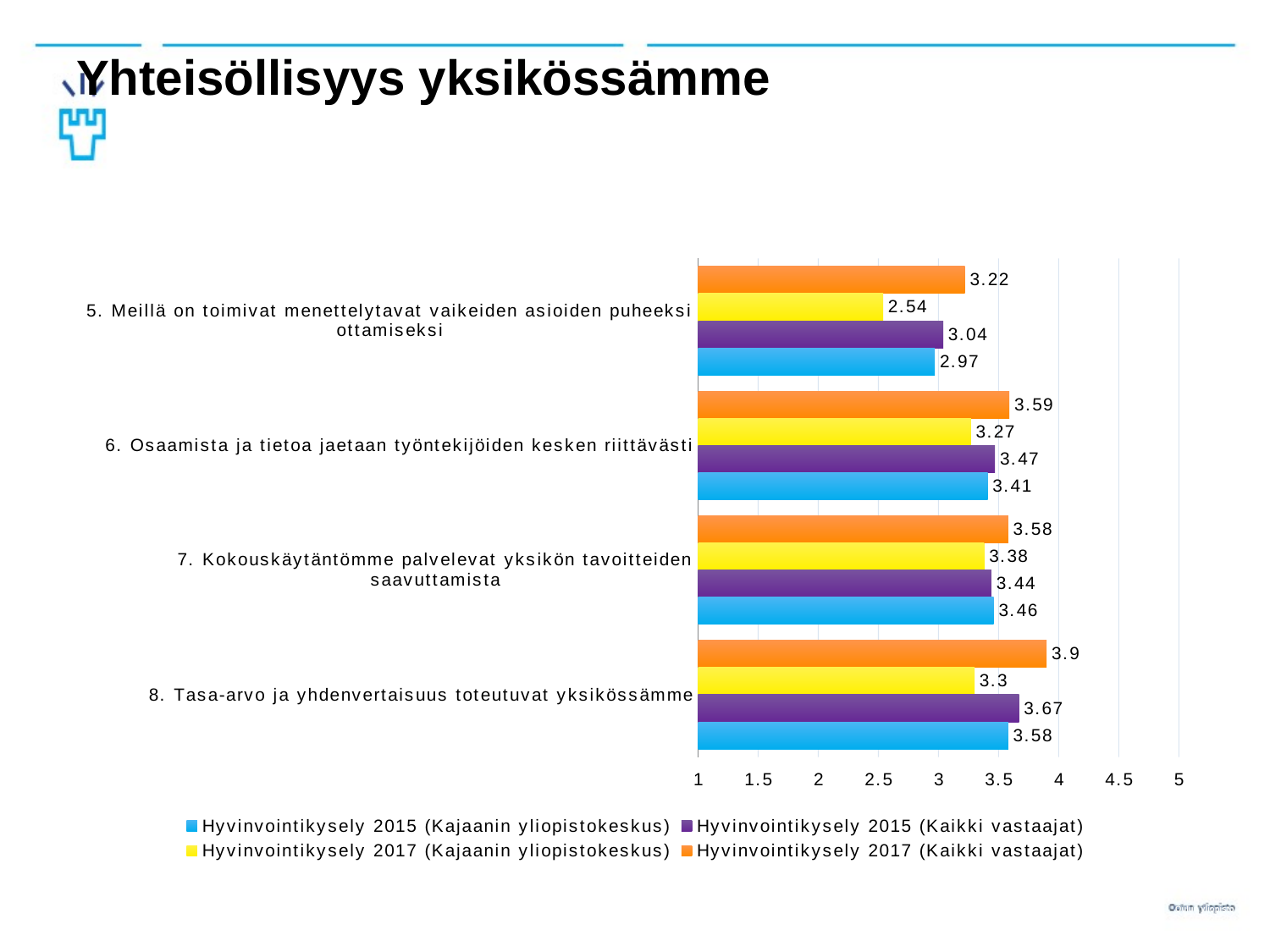
What is the value for Hyvinvointikysely 2015 (Kaikki vastaajat) for statement 7 (Kokouskäytäntömme palvelevat yksikön tavoitteiden saavuttamista)? 3.44 Which statement has the highest value for Hyvinvointikysely 2017 (Kaikki vastaajat)? 8. Tasa-arvo ja yhdenvertaisuus toteutuvat yksikössämme How many series does the legend list? 4 What is the value for Hyvinvointikysely 2017 (Kajaanin yliopistokeskus) for statement 5 (Meillä on toimivat menettelytavat vaikeiden asioiden puheeksi ottamiseksi)? 2.54 Which statement has the lowest value for Hyvinvointikysely 2017 (Kajaanin yliopistokeskus)? 5. Meillä on toimivat menettelytavat vaikeiden asioiden puheeksi ottamiseksi What is the value for Hyvinvointikysely 2015 (Kajaanin yliopistokeskus) for statement 6 (Osaamista ja tietoa jaetaan työntekijöiden kesken riittävästi)? 3.41 What is the difference between the Hyvinvointikysely 2017 (Kaikki vastaajat) value and the Hyvinvointikysely 2017 (Kajaanin yliopistokeskus) value for statement 8? 0.6 How many categories (statements) are plotted on the chart? 4 For statement 6, which is larger: the Hyvinvointikysely 2015 (Kaikki vastaajat) value or the Hyvinvointikysely 2017 (Kajaanin yliopistokeskus) value? Hyvinvointikysely 2015 (Kaikki vastaajat) What is the value for Hyvinvointikysely 2017 (Kaikki vastaajat) for statement 8 (Tasa-arvo ja yhdenvertaisuus toteutuvat yksikössämme)? 3.9 Which colour represents Hyvinvointikysely 2017 (Kaikki vastaajat) in the chart? orange What kind of chart is shown on the slide? bar chart